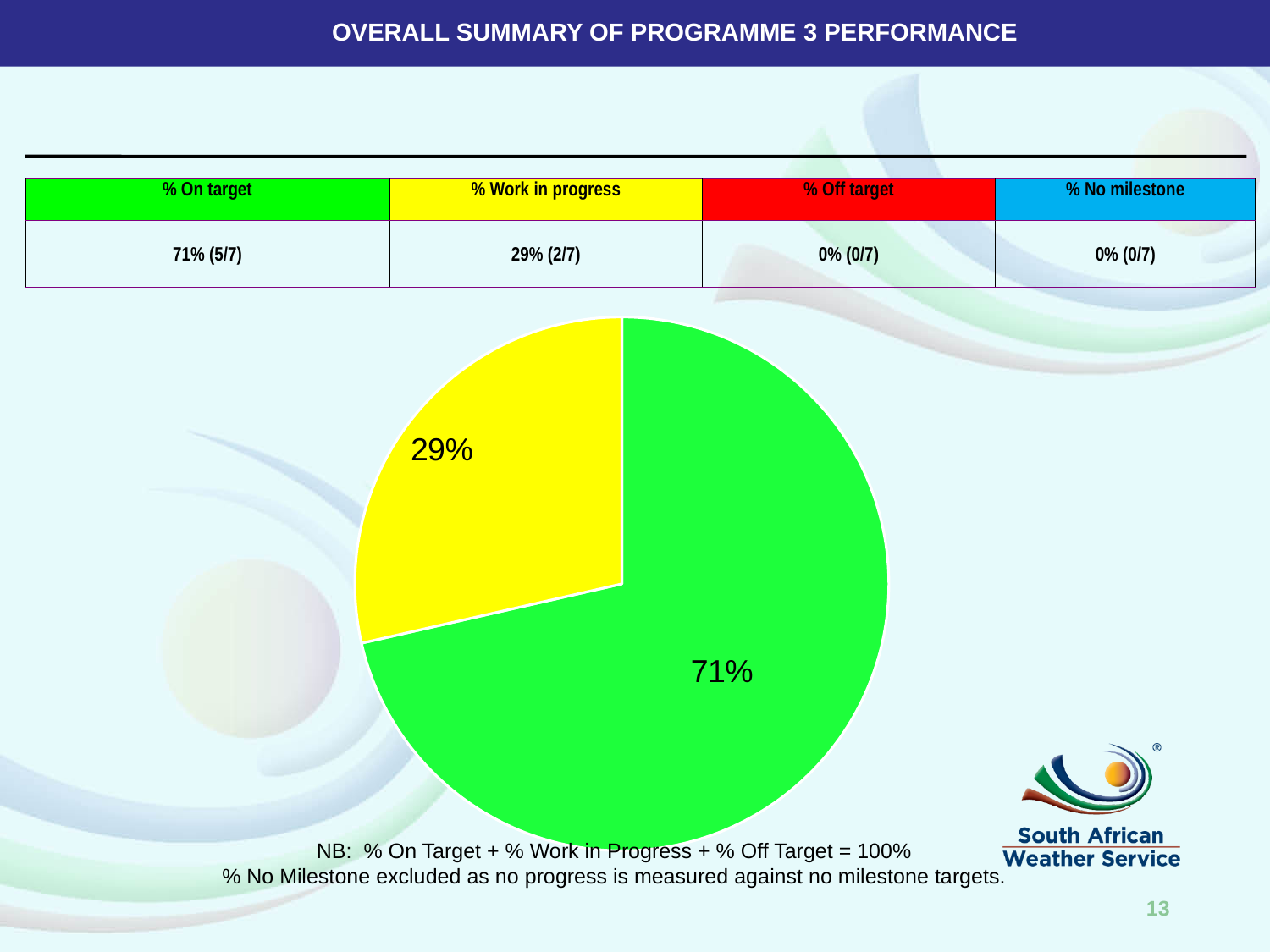
According to the table above the pie chart, which category does the green colour represent? % On target According to the table above the pie chart, which category does the yellow colour represent? % Work in progress Is the value of the green slice of the pie chart greater or less than 50%? greater What kind of chart is shown on the slide? pie chart What percentage is shown on the yellow slice of the pie chart? 29% Which slice of the pie chart is the largest? the green slice (71%) Which slice of the pie chart is the smallest? the yellow slice (29%) What percentage is shown on the green slice of the pie chart? 71% What is the difference in percentage points between the green slice and the yellow slice of the pie chart? 42 How many slices with visible labels does the pie chart have? 2 What is the total of the two labelled slices in the pie chart? 100% Is the green slice or the yellow slice of the pie chart larger? the green slice